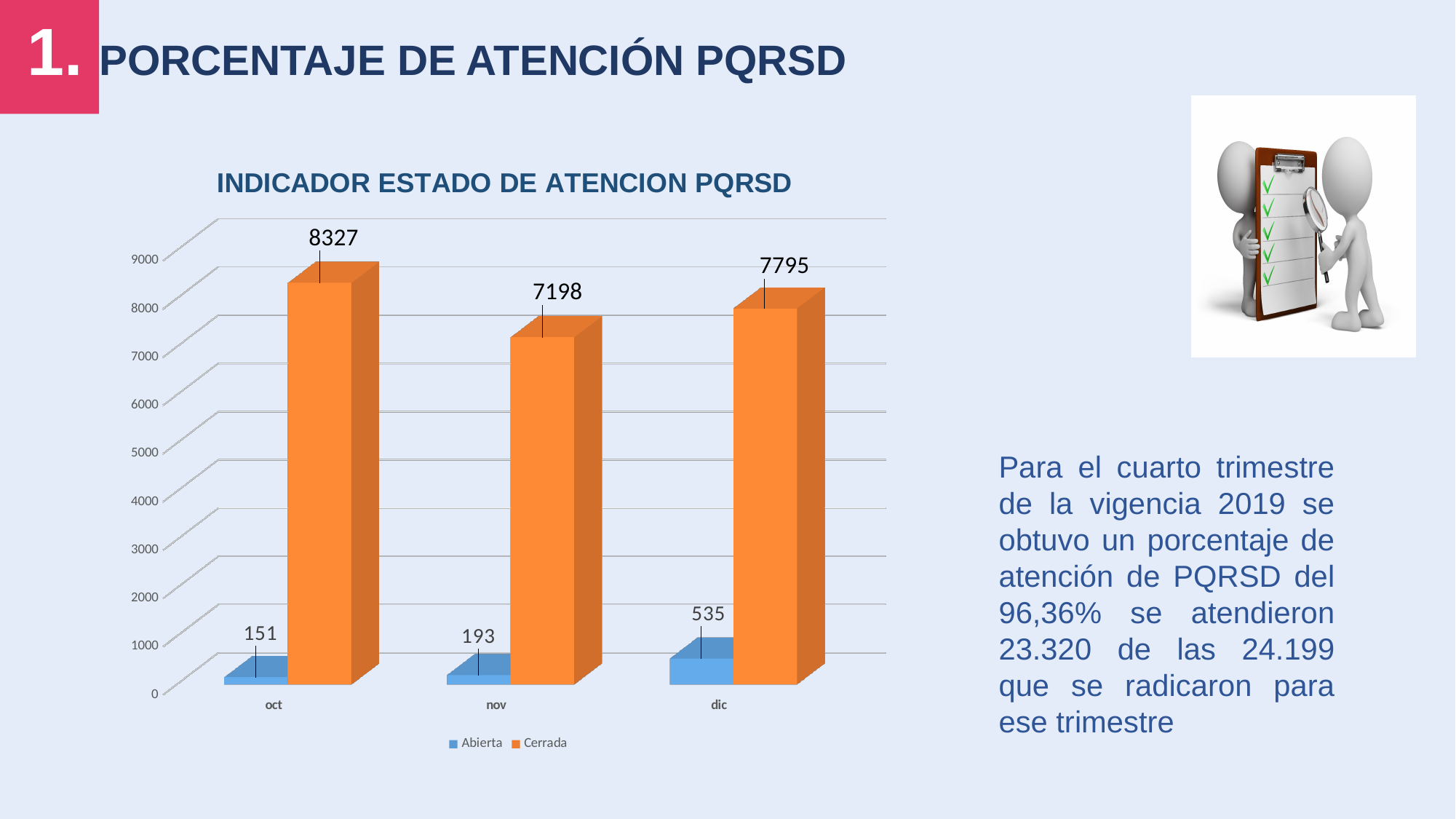
How many months are shown on the x axis? 3 What is the title of the chart? INDICADOR ESTADO DE ATENCION PQRSD What is the value of Abierta for dic? 535 What kind of chart is shown? bar chart What is the difference between the Cerrada values for oct and nov? 1129 Is the Cerrada value for nov greater or less than 7000? greater Which is larger, the Cerrada value for nov or for dic? dic What is the value of Abierta for nov? 193 What is the value of Cerrada for oct? 8327 How many series does the legend list? 2 Which month has the lowest Abierta value? oct Which month has the highest Cerrada value? oct